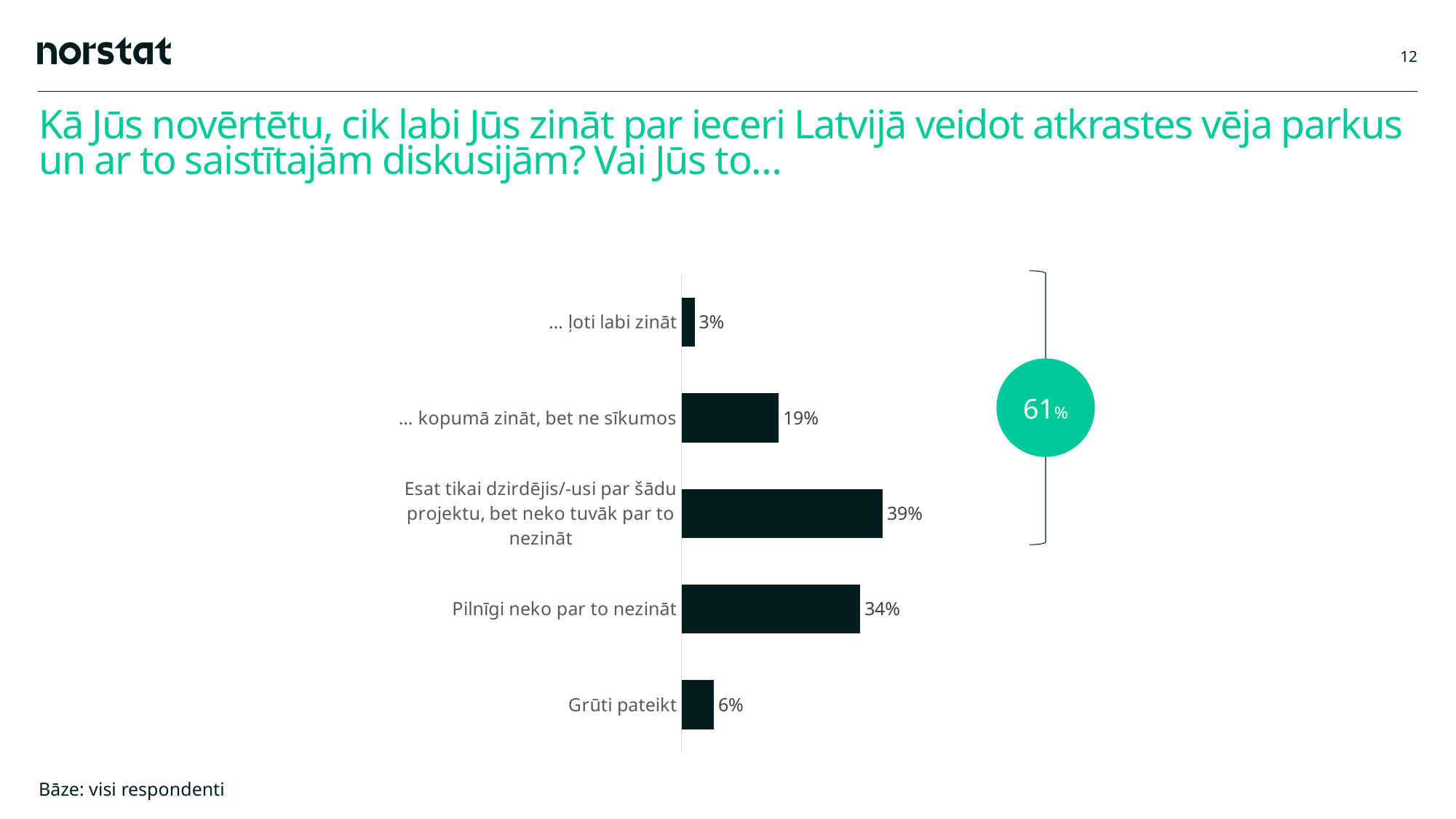
How many categories are shown in the chart? 5 Which is larger: the value for "Grūti pateikt" or the value for "... ļoti labi zināt"? Grūti pateikt What kind of chart is shown on the slide? Bar chart What is the value for "... ļoti labi zināt"? 3% What is the value for "... kopumā zināt, bet ne sīkumos"? 19% What percentage is shown in the green circle next to the chart? 61% What is the difference between the values for "Pilnīgi neko par to nezināt" and "... kopumā zināt, bet ne sīkumos"? 15% What is the value for "Grūti pateikt"? 6% Which category has the highest value? Esat tikai dzirdējis/-usi par šādu projektu, bet neko tuvāk par to nezināt What is the value for "Esat tikai dzirdējis/-usi par šādu projektu, bet neko tuvāk par to nezināt"? 39% What is the value for "Pilnīgi neko par to nezināt"? 34% Which category has the lowest value? ... ļoti labi zināt